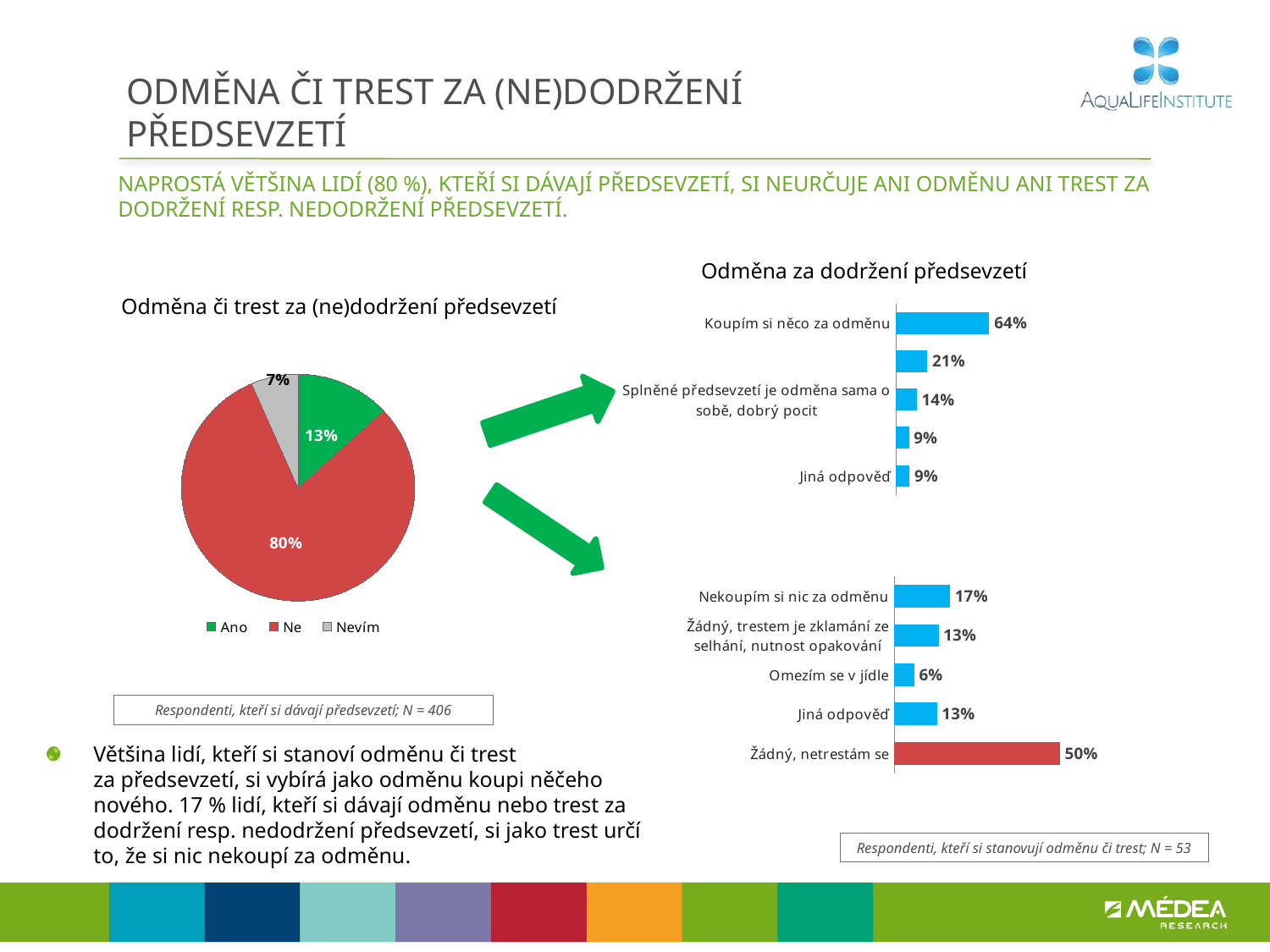
In the lower bar chart on the right of the slide, what is the value for "Žádný, netrestám se"? 50% In the chart "Odměna za dodržení předsevzetí", what is the value for "Splněné předsevzetí je odměna sama o sobě, dobrý pocit"? 14% In the chart "Odměna za dodržení předsevzetí", which category has the highest value? Koupím si něco za odměnu In the pie chart "Odměna či trest za (ne)dodržení předsevzetí", what share is shown for "Ne"? 80% In the pie chart "Odměna či trest za (ne)dodržení předsevzetí", what is the difference between the shares for "Ne" and "Ano"? 67% In the chart "Odměna za dodržení předsevzetí", what is the value for "Koupím si něco za odměnu"? 64% In the lower bar chart on the right of the slide, which category has the lowest value? Omezím se v jídle In the pie chart "Odměna či trest za (ne)dodržení předsevzetí", which category has the smallest slice? Nevím What kind of chart is "Odměna za dodržení předsevzetí"? Bar chart In the lower bar chart on the right of the slide, which is larger: "Nekoupím si nic za odměnu" or "Omezím se v jídle"? Nekoupím si nic za odměnu How many entries does the legend of the pie chart "Odměna či trest za (ne)dodržení předsevzetí" list? 3 In the pie chart "Odměna či trest za (ne)dodržení předsevzetí", what share is shown for "Ano"? 13%